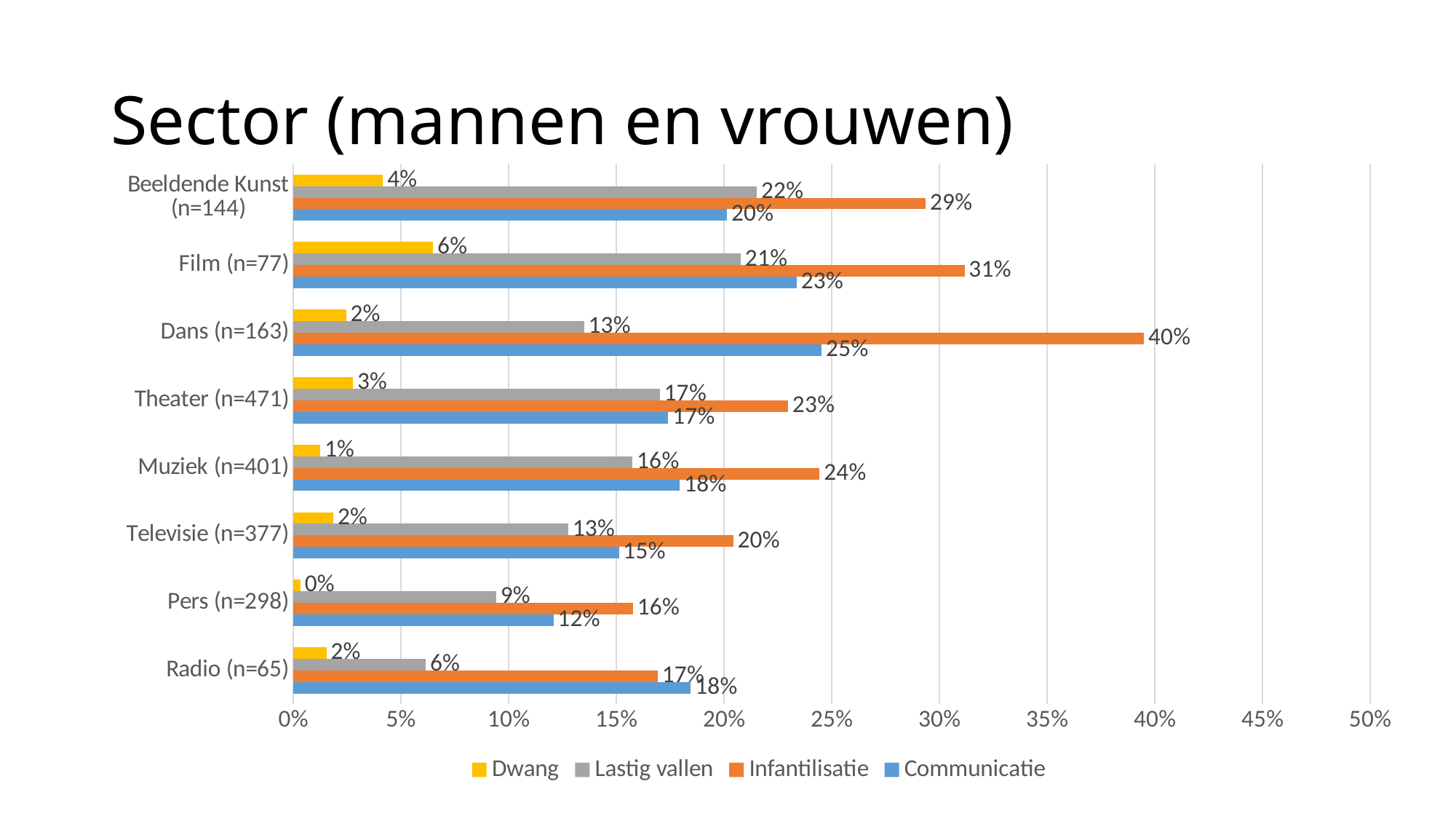
How many sectors are shown on the chart? 8 What is the title of the slide? Sector (mannen en vrouwen) What is the Infantilisatie value for Dans (n=163)? 40% What is the Communicatie value for Film (n=77)? 23% What is the difference between the Infantilisatie and Communicatie values for Dans (n=163)? 15% How many series does the legend list? 4 Is the Infantilisatie value for Film (n=77) greater or less than 30%? greater What is the Lastig vallen value for Pers (n=298)? 9% What kind of chart is shown on the slide? Bar chart Which sector has the lowest Lastig vallen value? Radio (n=65) Which is larger for Beeldende Kunst (n=144): the Lastig vallen value or the Communicatie value? Lastig vallen Which sector has the highest Infantilisatie value? Dans (n=163)